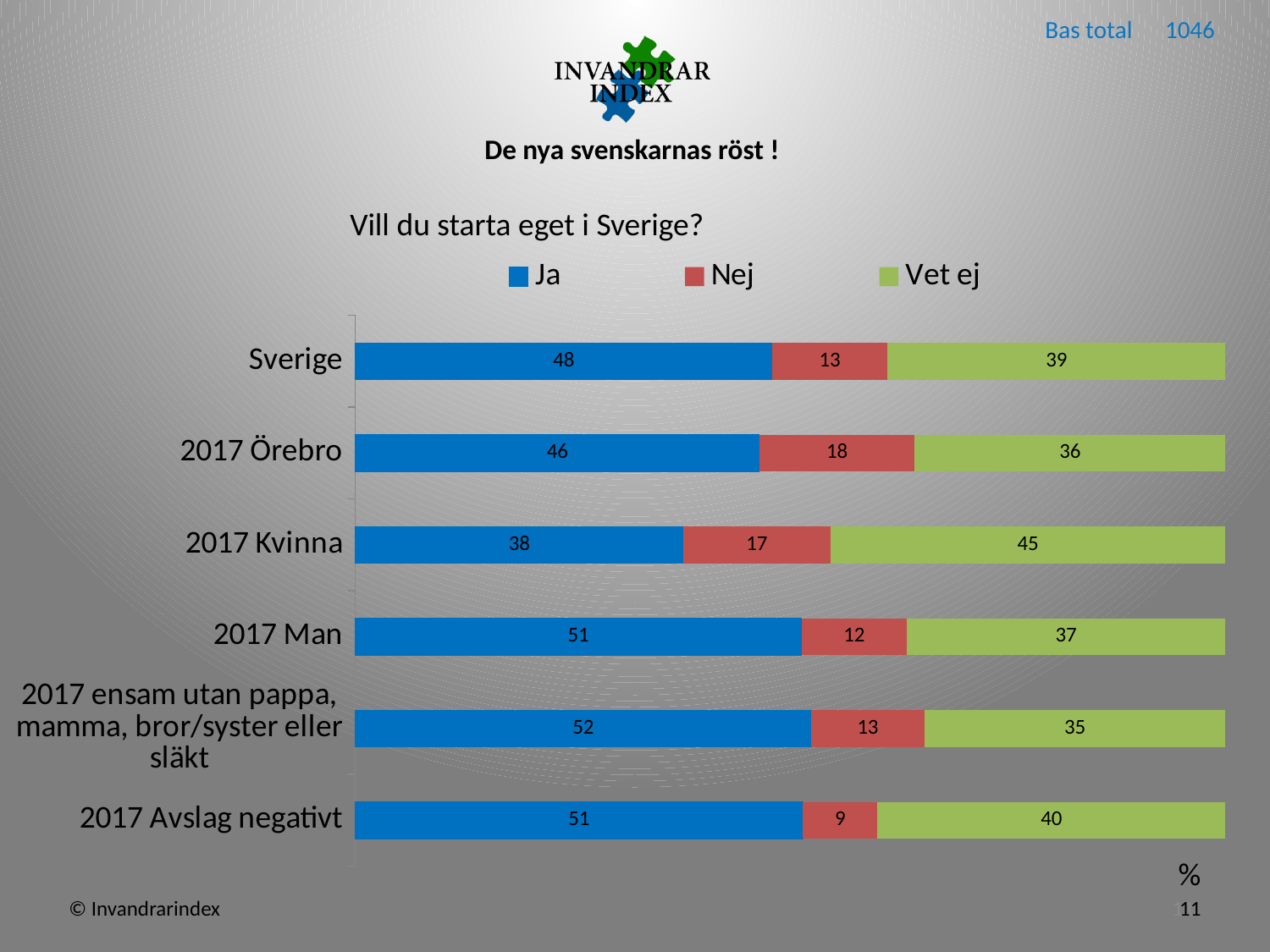
What is the value for "Vet ej" in the "2017 Kvinna" category? 45 What is the value for "Ja" in the "Sverige" category? 48 What is the difference between the "Ja" values for "2017 Man" and "2017 Kvinna"? 13 What kind of chart is shown on the slide? Stacked bar chart How many series does the legend list? 3 What is the value for "Nej" in the "2017 Avslag negativt" category? 9 Which is larger: the "Vet ej" value for "Sverige" or for "2017 Örebro"? Sverige Which category has the lowest value for "Ja"? 2017 Kvinna How many categories are shown on the chart? 6 What is the title of the chart? Vill du starta eget i Sverige? What is the value for "Nej" in the "2017 Örebro" category? 18 Which category has the highest value for "Ja"? 2017 ensam utan pappa, mamma, bror/syster eller släkt